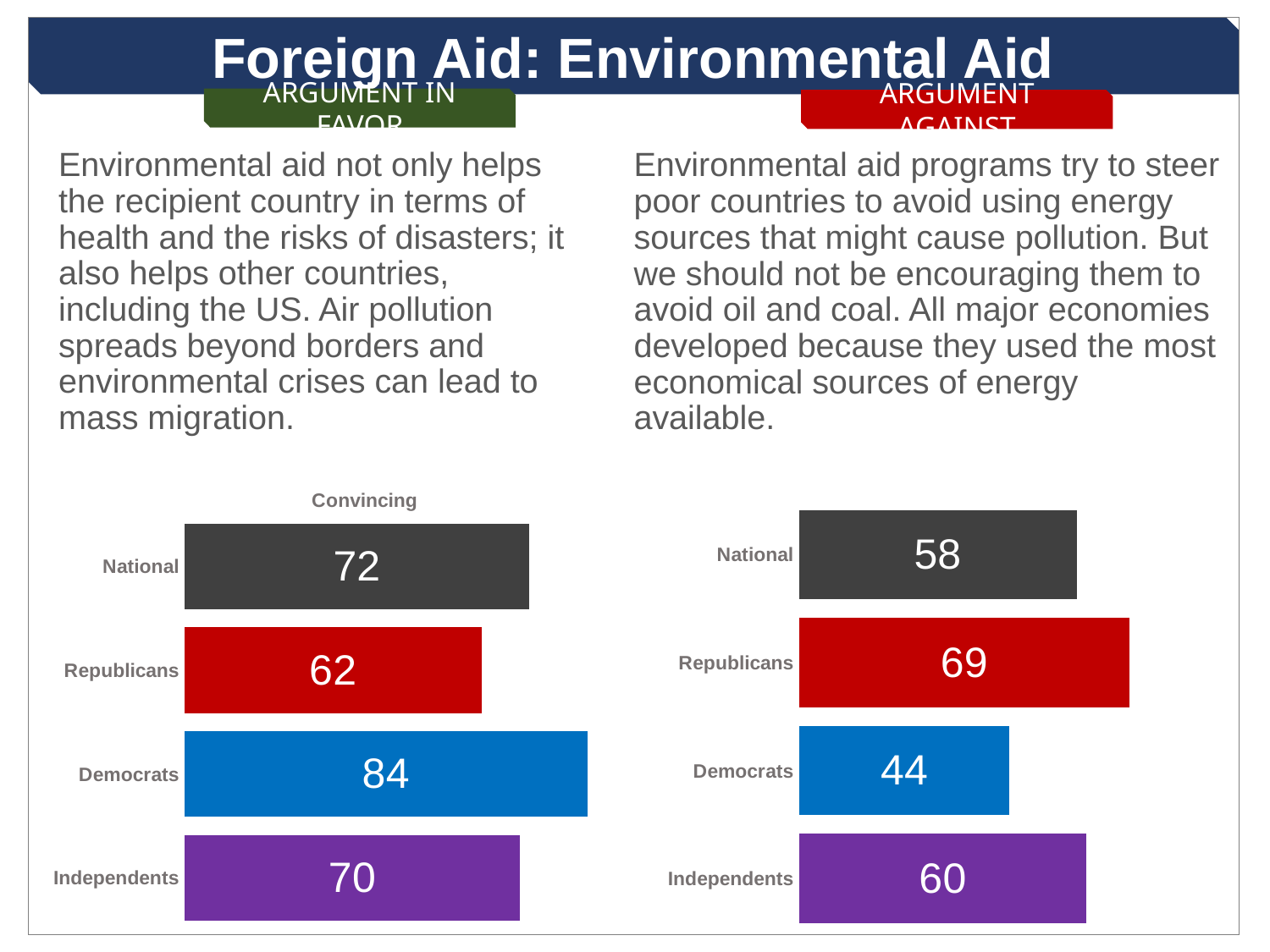
In the left chart (Argument in Favor), which group has the highest value? Democrats In the left chart (Argument in Favor), what is the difference between the Democrats value and the National value? 12 In the right chart (Argument Against), which group has the lowest value? Democrats What kind of chart is the right chart (Argument Against)? Bar chart In the left chart (Argument in Favor), what is the National value? 72 Which is larger: the Independents value in the left chart (Argument in Favor) or the Independents value in the right chart (Argument Against)? Left chart (Argument in Favor) In the right chart (Argument Against), what is the value for Republicans? 69 In the right chart (Argument Against), what is the difference between the Republicans value and the Democrats value? 25 In the left chart (Argument in Favor), which group has the lowest value? Republicans How many categories are shown in the left chart (Argument in Favor)? 4 In the right chart (Argument Against), what is the value for Independents? 60 In the left chart (Argument in Favor), what is the value for Democrats? 84